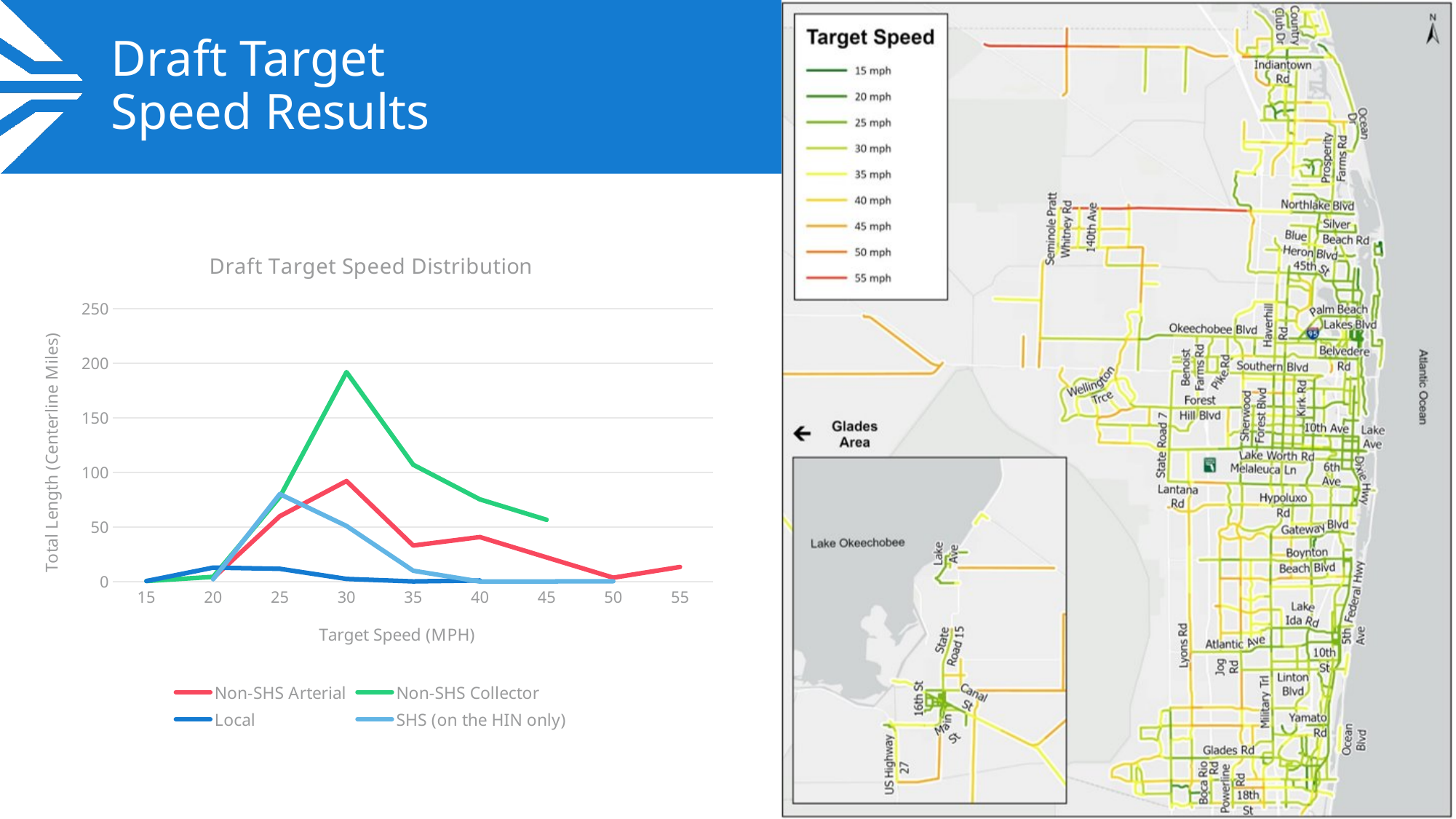
What kind of chart is the Draft Target Speed Distribution chart? line chart In the Draft Target Speed Distribution chart, is the SHS (on the HIN only) value at 25 MPH greater or less than 50? greater In the Draft Target Speed Distribution chart, at which target speed does the Non-SHS Collector series peak? 30 In the Draft Target Speed Distribution chart, is the Non-SHS Collector value at 30 MPH greater or less than 150? greater In the Draft Target Speed Distribution chart, does the Non-SHS Collector series rise or fall between 30 and 45 MPH? fall In the Draft Target Speed Distribution chart, at 30 MPH, which is larger: Non-SHS Collector or Non-SHS Arterial? Non-SHS Collector How many series does the legend of the Draft Target Speed Distribution chart list? 4 In the Draft Target Speed Distribution chart, which series reaches the highest value? Non-SHS Collector In the Draft Target Speed Distribution chart, is the Non-SHS Arterial value at 30 MPH greater or less than 50? greater How many target speed values are marked on the x axis of the Draft Target Speed Distribution chart? 9 What is the y-axis title of the Draft Target Speed Distribution chart? Total Length (Centerline Miles)